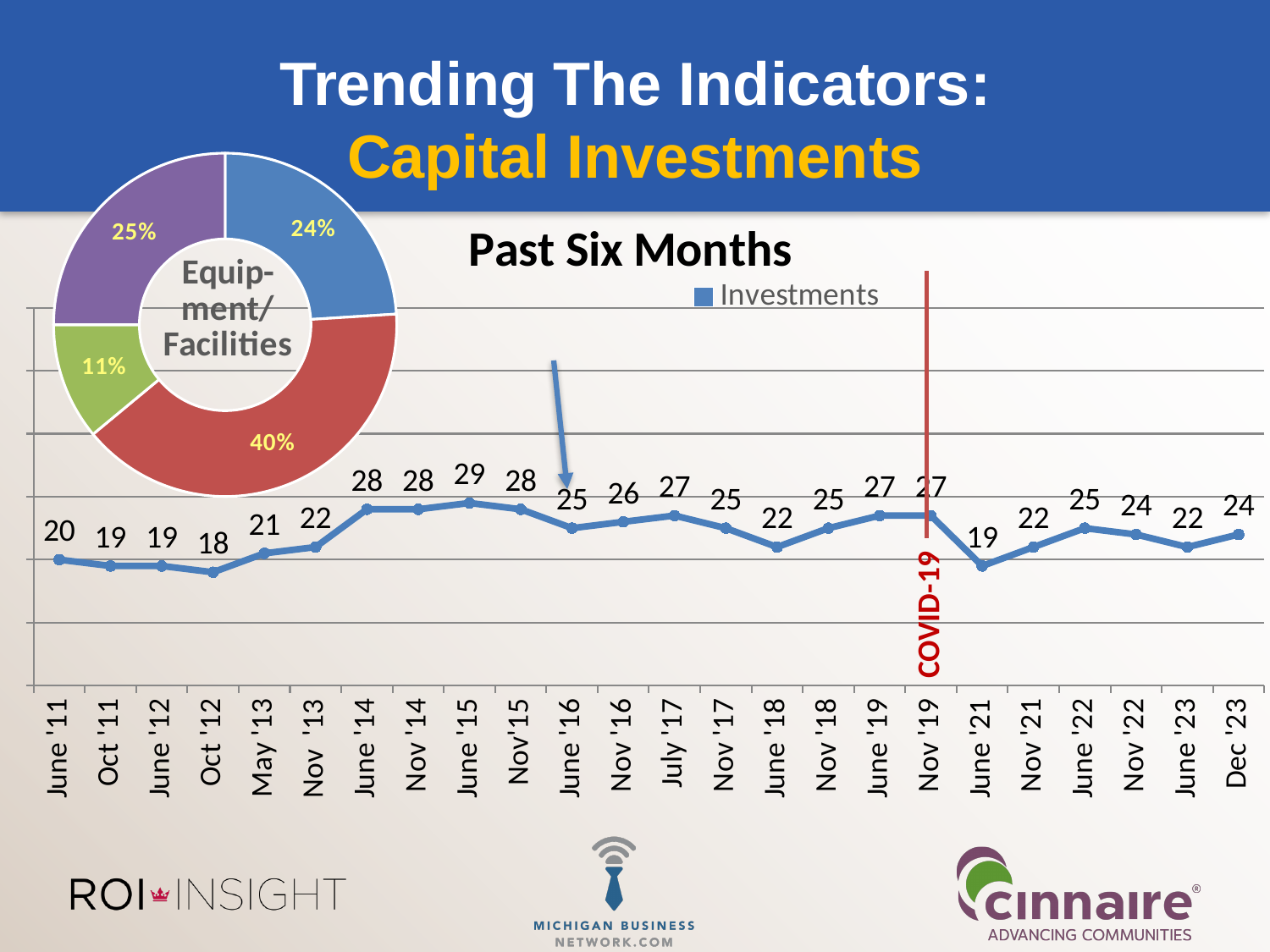
What kind of chart is the "Past Six Months" chart? Line chart In the line chart titled "Past Six Months", what is the difference between the values for June '15 and Oct '12? 11 How many slices does the donut chart labelled "Equipment/Facilities" at the top left have? 4 In the line chart titled "Past Six Months", which is larger, the value for Nov '19 or the value for June '21? Nov '19 How many data points are plotted in the line chart titled "Past Six Months"? 24 In the line chart titled "Past Six Months", which date has the lowest value? Oct '12 In the line chart titled "Past Six Months", what is the value for June '15? 29 In the line chart titled "Past Six Months", what is the value for June '21? 19 How many series does the legend of the line chart titled "Past Six Months" list? 1 In the line chart titled "Past Six Months", which date has the highest value? June '15 In the donut chart labelled "Equipment/Facilities" at the top left, what is the share of the largest slice? 40% In the line chart titled "Past Six Months", what is the value for Dec '23? 24